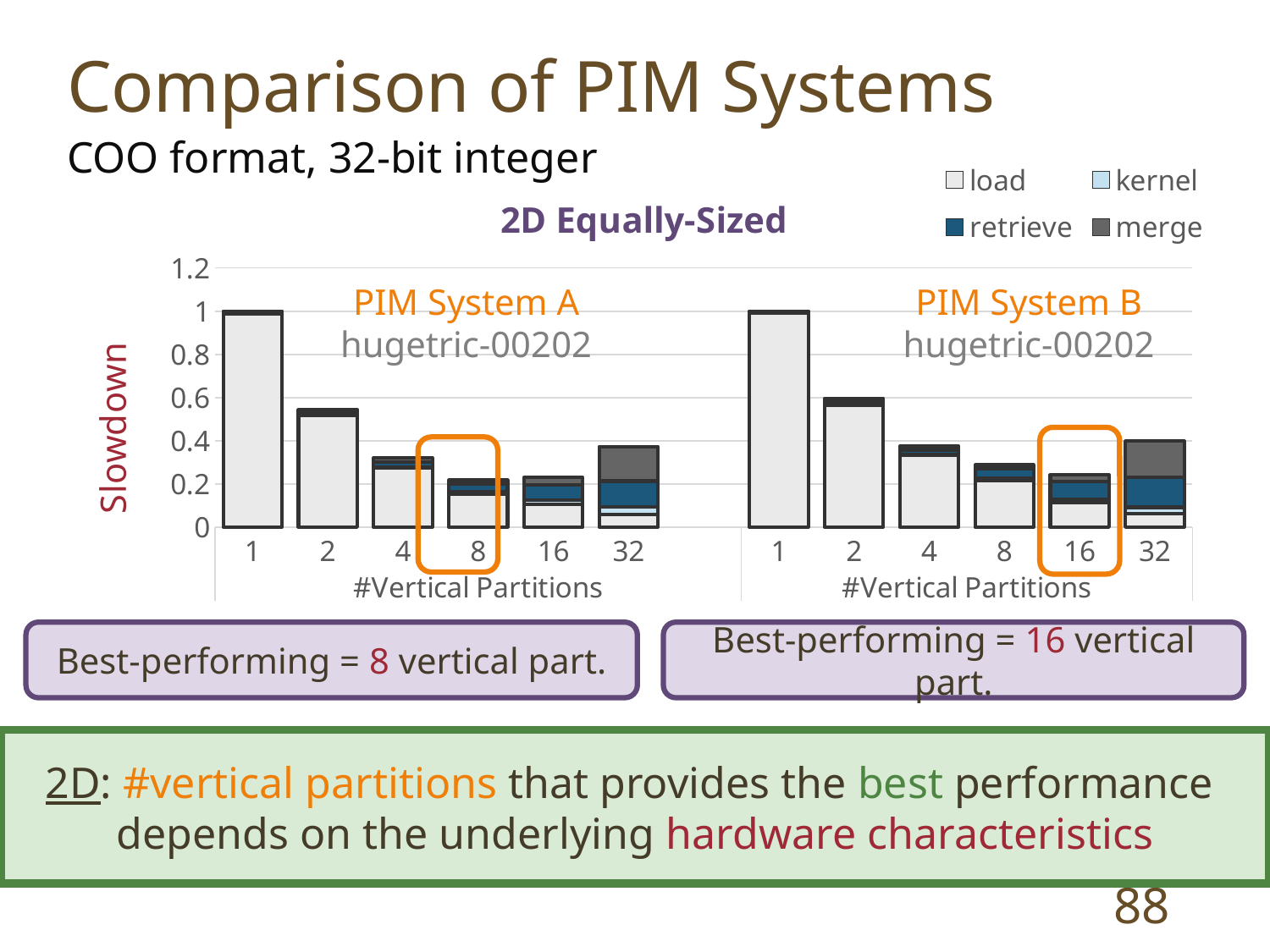
In the PIM System B chart, is the slowdown for 4 vertical partitions greater or less than 0.6? less In the PIM System A chart, what is the slowdown for 1 vertical partition? 1 What kind of chart is used for PIM System A? Stacked bar chart In the PIM System B chart, which number of vertical partitions has the lowest slowdown? 16 Which series are listed in the legend? load, kernel, retrieve, merge In the PIM System A chart, which number of vertical partitions has the lowest slowdown? 8 In the PIM System B chart, which number of vertical partitions has the highest slowdown? 1 In the PIM System A chart, is the slowdown for 2 vertical partitions greater or less than 0.4? greater How many #Vertical Partitions categories are shown in the PIM System B chart? 6 In the PIM System A chart, which has the larger slowdown: 2 vertical partitions or 4 vertical partitions? 2 vertical partitions How many series does the legend list? 4 In the PIM System B chart, does the slowdown rise or fall as the number of vertical partitions goes from 1 to 8? fall